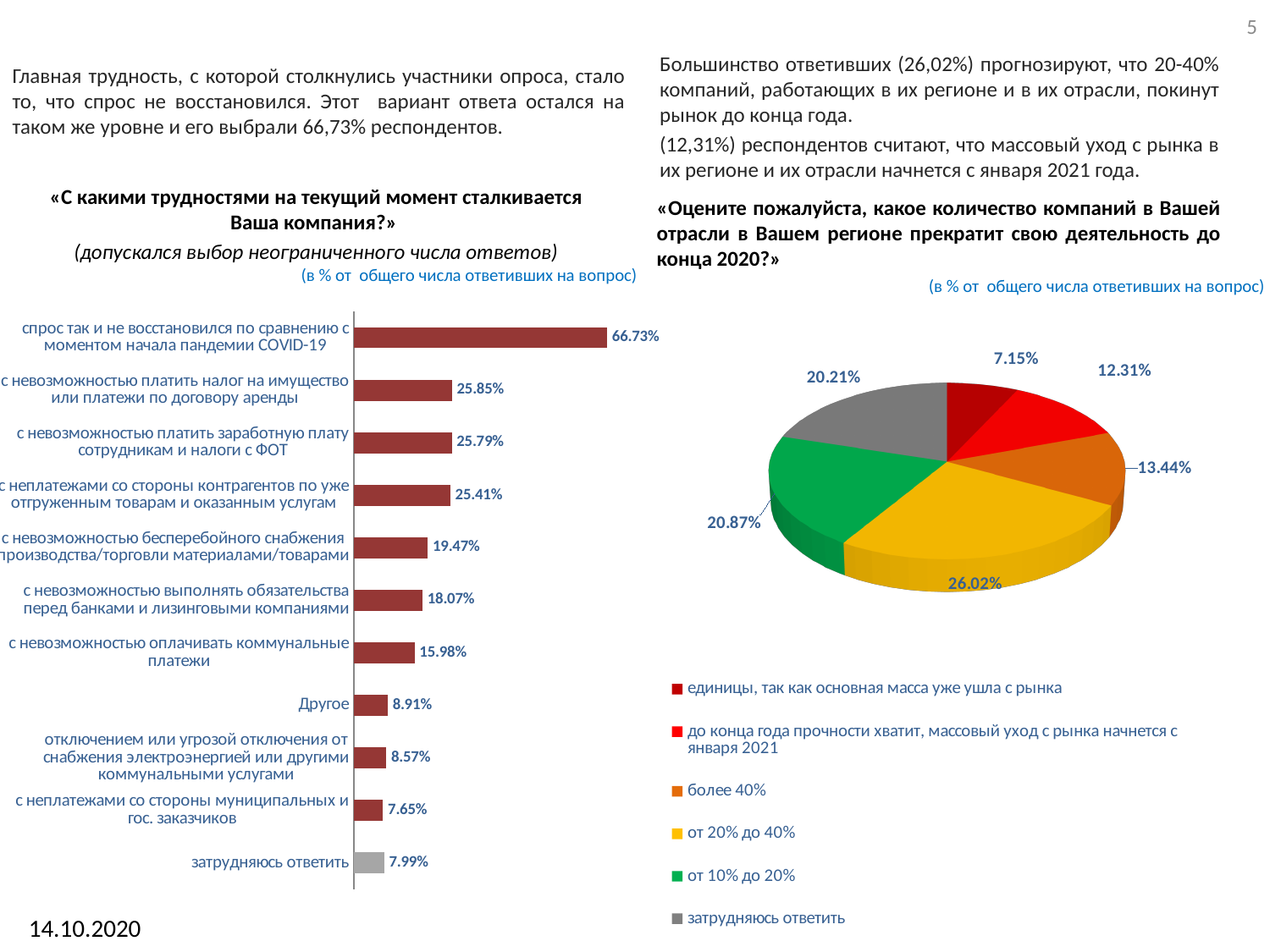
In the left bar chart, which category has the lowest value? с неплатежами со стороны муниципальных и гос. заказчиков In the left bar chart, which category has the highest value? спрос так и не восстановился по сравнению с моментом начала пандемии COVID-19 In the left bar chart, what is the value for «с невозможностью оплачивать коммунальные платежи»? 15.98% What type of chart is on the left side of the slide? bar chart In the left bar chart, what percentage of respondents chose «спрос так и не восстановился по сравнению с моментом начала пандемии COVID-19»? 66.73% In the left bar chart, which is larger: the value for «с невозможностью бесперебойного снабжения производства/торговли материалами/товарами» or for «с невозможностью выполнять обязательства перед банками и лизинговыми компаниями»? с невозможностью бесперебойного снабжения производства/торговли материалами/товарами In the right pie chart, which slice is the smallest? единицы, так как основная масса уже ушла с рынка How many entries does the legend of the right pie chart list? 6 In the left bar chart, what is the difference between the values for «Другое» and «затрудняюсь ответить»? 0.92% In the right pie chart, what is the value for «более 40%»? 13.44% In the right pie chart, what share corresponds to «от 20% до 40%»? 26.02% How many categories are shown in the left bar chart? 11